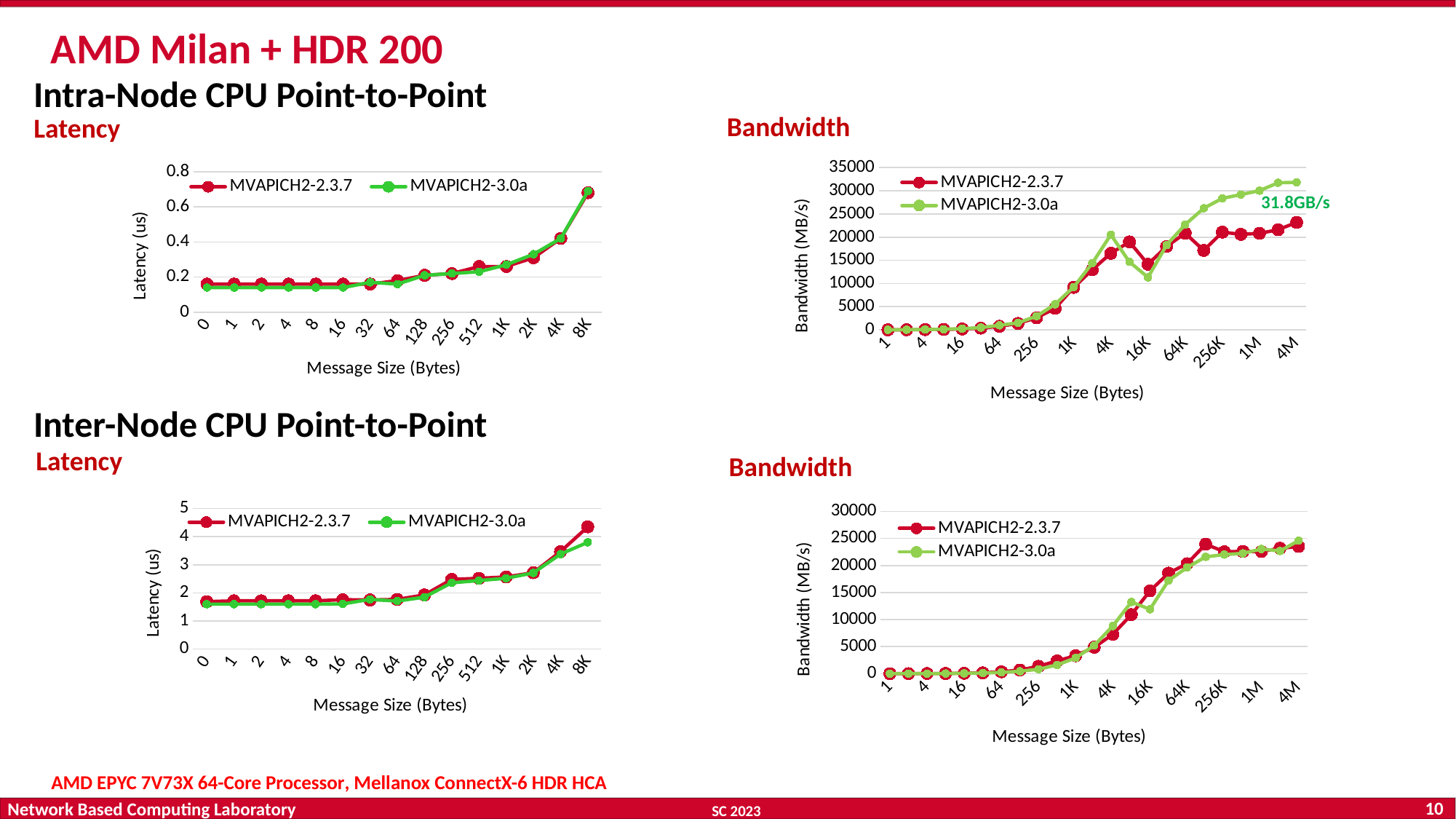
On the Intra-Node Bandwidth chart, is the MVAPICH2-2.3.7 value at 4M greater or less than 25000? less On the Intra-Node Latency chart, at which message size is the latency highest? 8K On the Intra-Node Latency chart, is the MVAPICH2-2.3.7 value at 8K greater or less than 0.6? greater On the Inter-Node Latency chart, which series has the higher latency at 8K? MVAPICH2-2.3.7 On the Intra-Node Bandwidth chart, what value is labelled on the MVAPICH2-3.0a line at the largest message size? 31.8GB/s On the Inter-Node Latency chart, is the MVAPICH2-3.0a value at 8K greater or less than 4? less On the Inter-Node Bandwidth chart, does bandwidth generally rise or fall as message size increases? Rise How many series does the legend of the Inter-Node Bandwidth chart list? 2 What kind of chart is the Intra-Node Latency chart? Line chart How many message sizes are shown on the x axis of the Intra-Node Latency chart? 15 On the Intra-Node Bandwidth chart, which series reaches the higher bandwidth at 4M? MVAPICH2-3.0a